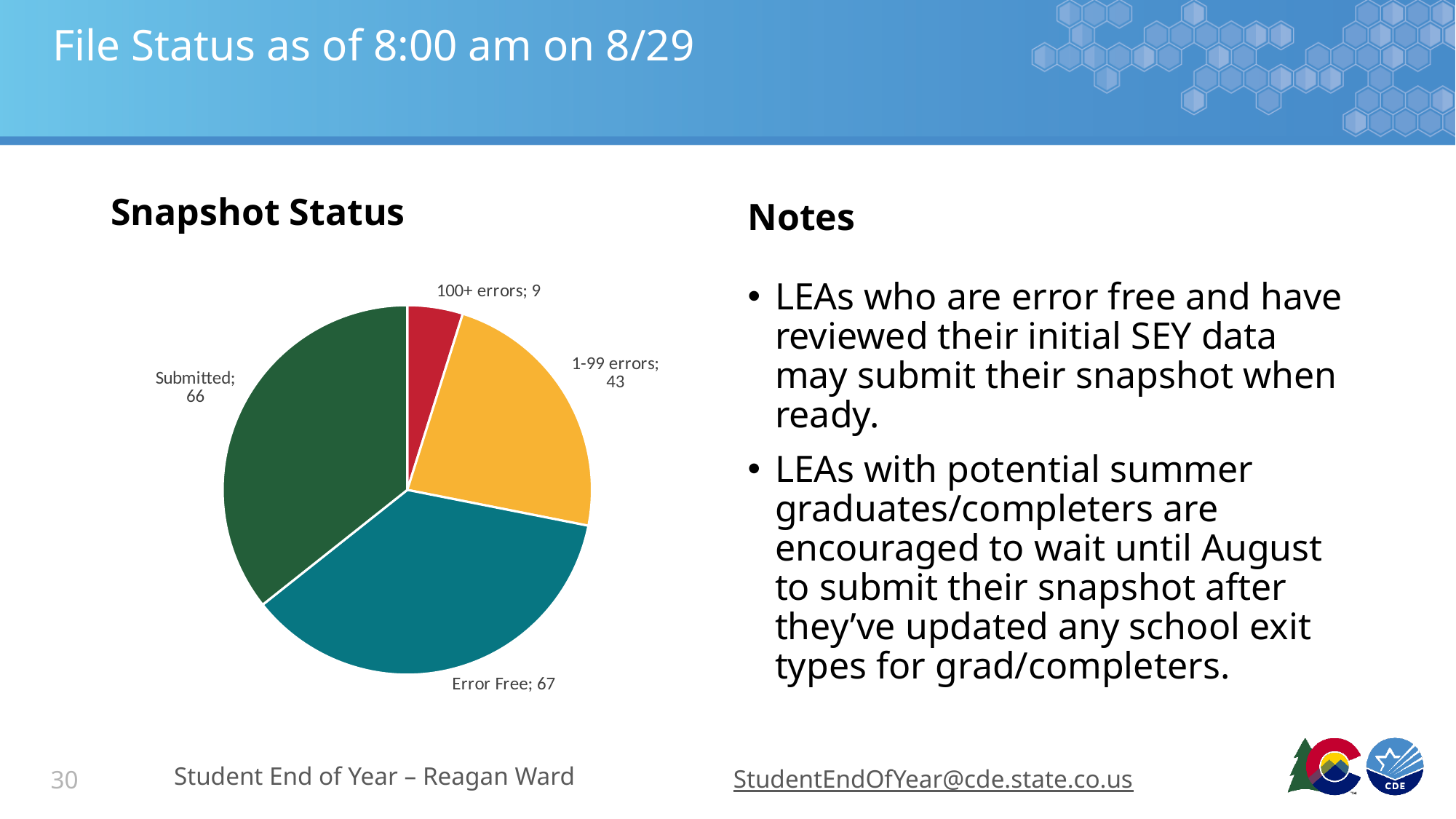
In the Snapshot Status pie chart, what is the value for 100+ errors? 9 In the Snapshot Status pie chart, which is larger: 1-99 errors or Submitted? Submitted What kind of chart is shown under the heading "Snapshot Status"? pie chart In the Snapshot Status pie chart, what is the value for Error Free? 67 In the Snapshot Status pie chart, what is the value for 1-99 errors? 43 In the Snapshot Status pie chart, what is the value for Submitted? 66 What is the total of all four slices in the Snapshot Status pie chart? 185 How many slices does the Snapshot Status pie chart have? 4 In the Snapshot Status pie chart, what is the difference between the Error Free value and the 1-99 errors value? 24 What colour is the Error Free slice in the Snapshot Status pie chart? teal Which category in the Snapshot Status pie chart has the smallest value? 100+ errors Which category in the Snapshot Status pie chart has the largest value? Error Free